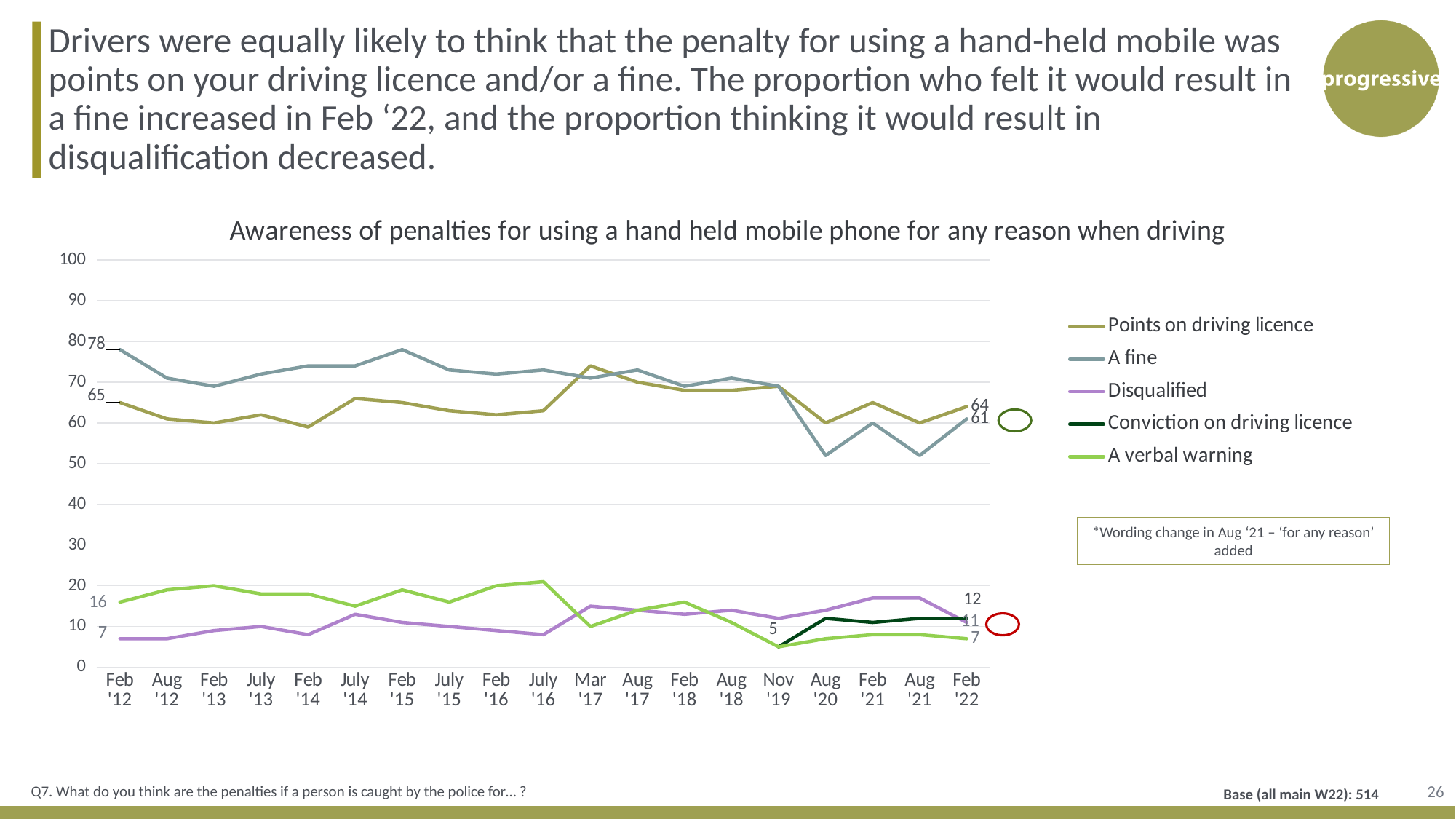
What is the value for 'Disqualified' in Feb '22? 11 What is the value for 'A fine' in Feb '12? 78 What kind of chart is shown on the slide? Line chart In Feb '22, which is higher: 'Points on driving licence' or 'A fine'? Points on driving licence What is the value for 'A verbal warning' in Feb '22? 7 How many time points are shown along the x axis? 19 What is the value for 'Points on driving licence' in Feb '12? 65 What is the value for 'A fine' in Feb '22? 61 By how much did the value for 'A fine' fall between Feb '12 and Feb '22? 17 How many series does the legend list? 5 What is the value for 'Points on driving licence' in Feb '22? 64 Is the value for 'A fine' in Aug '20 greater or less than 60? less